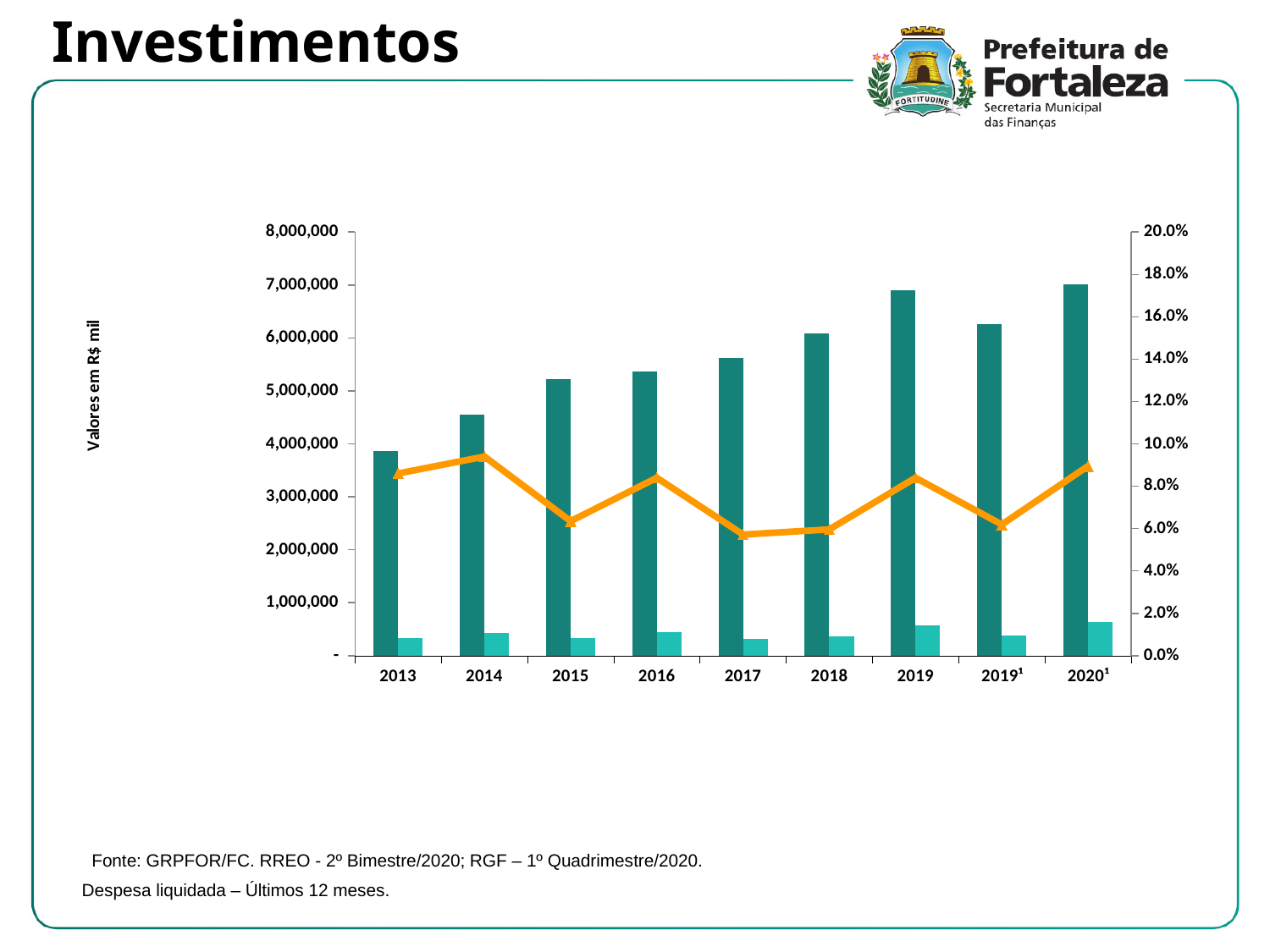
Do the dark teal bars rise or fall from 2013 to 2019? rise Is the dark teal bar for 2017 greater or less than 5,000,000? greater Which category has the highest light teal bar? 2020¹ Which category has the lowest dark teal bar? 2013 Is the orange line value for 2017 greater or less than 6.0%? less What kind of chart is shown on the slide? A bar chart combined with a line Is the orange line value for 2014 greater or less than 8.0%? greater What is the label on the left vertical axis of the chart? Valores em R$ mil Which has the larger dark teal bar, 2019 or 2019¹? 2019 How many categories are shown on the x axis of the chart? 9